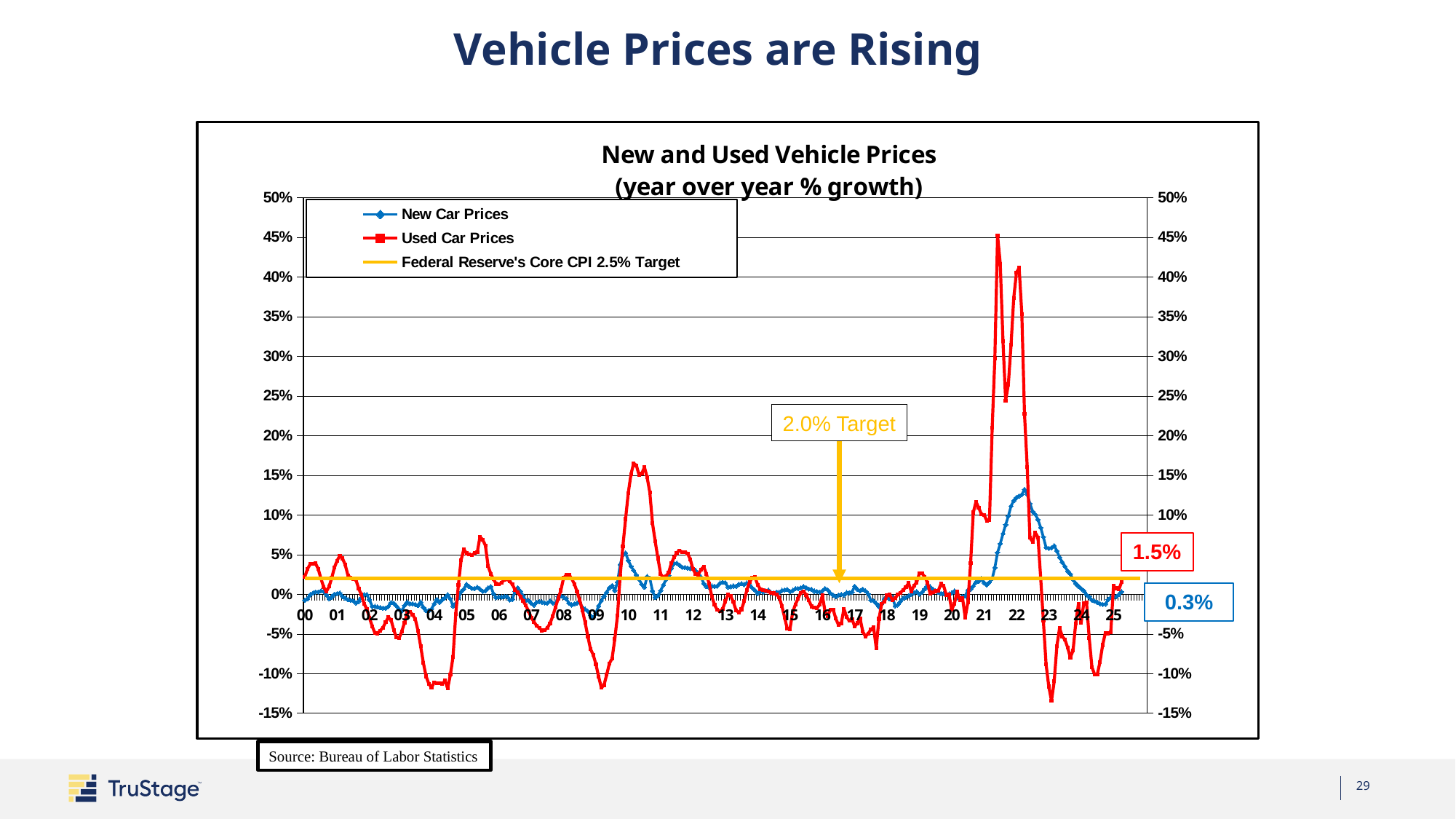
What is the difference between the latest labelled Used Car Prices value (1.5%) and the latest labelled New Car Prices value (0.3%)? 1.2% What is the latest labelled value for Used Car Prices? 1.5% Which series reaches the highest peak on the chart? Used Car Prices Which is larger at the end of the series, the labelled value for Used Car Prices or for New Car Prices? Used Car Prices Is the peak value of Used Car Prices around 2021 greater or less than 40%? greater What is the latest labelled value for New Car Prices? 0.3% What kind of chart is shown on the slide? line chart What is the title of the chart? New and Used Vehicle Prices (year over year % growth) Is the peak value of New Car Prices around 2022 greater or less than 10%? greater Is the lowest value of Used Car Prices around 2023 greater or less than -10%? less Do Used Car Prices rise or fall between their 2021 peak and 2023? fall How many series does the chart legend list? 3